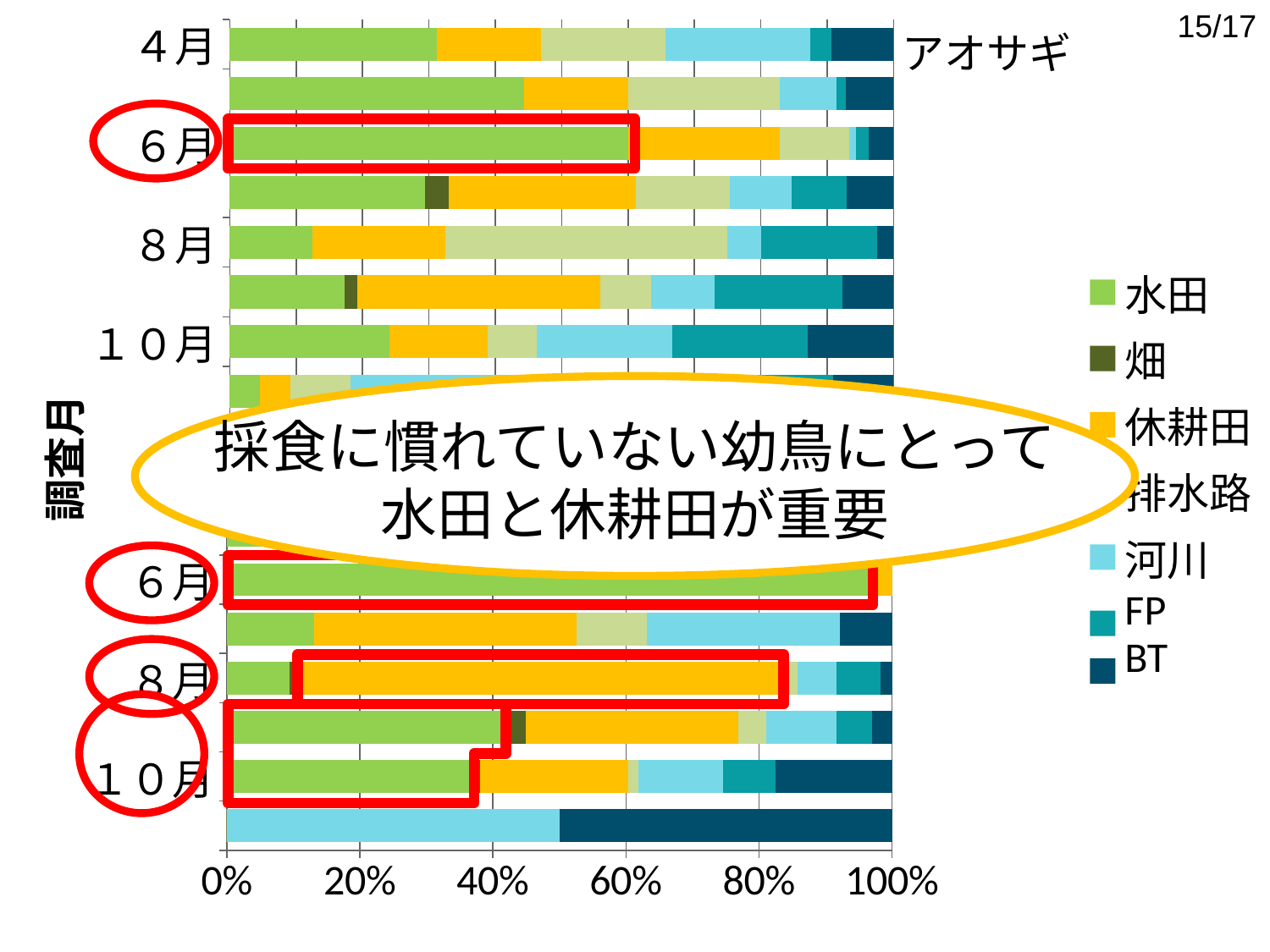
Which has the larger 水田 share: the 6月 bar in the lower half or the 8月 bar in the lower half? 6月 (lower half) Is the 水田 share for the 6月 bar in the lower half of the chart greater or less than 80%? greater Is the 水田 share for the 4月 bar greater or less than 40%? less What is the maximum value shown on the horizontal axis? 100% How many series does the legend list? 7 What is the title of the chart? アオサギ Is the 水田 share for the 8月 bar in the lower half of the chart greater or less than 20%? less Which has the larger 水田 share: the 4月 bar or the 6月 bar in the upper half of the chart? 6月 Among the labeled months, which bar has the largest 水田 share? 6月 (lower half) What kind of chart is shown on the slide? Stacked bar chart What is the label of the vertical axis? 調査月